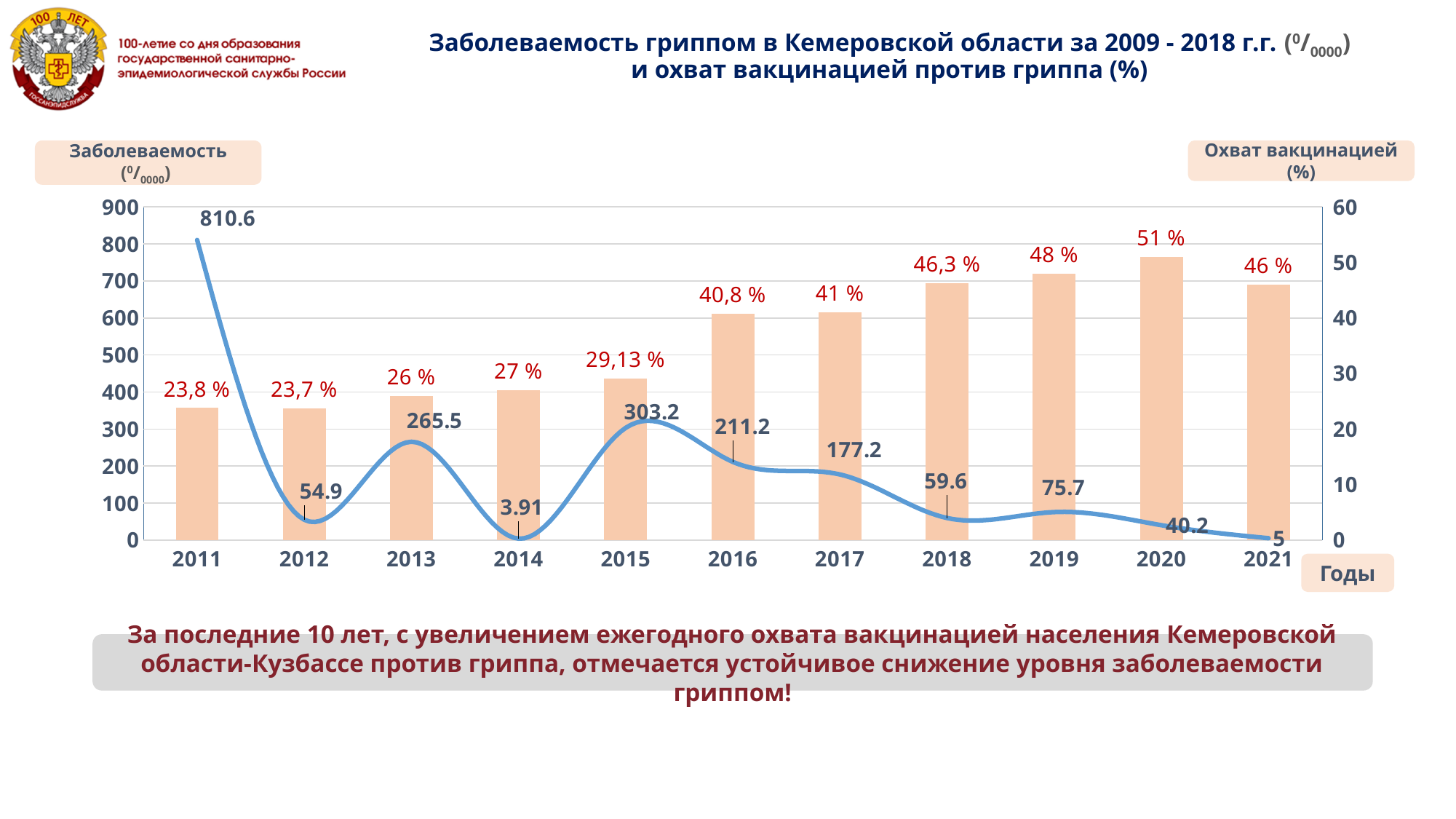
What type of chart is used to show vaccination coverage? Bar chart What was the vaccination coverage against flu in 2020? 51 % What is the difference in vaccination coverage between 2020 and 2021? 5 % In which year was the flu incidence highest? 2011 In which year was the vaccination coverage highest? 2020 What is the overall trend of flu incidence from 2011 to 2021? Falling What was the vaccination coverage in 2015? 29,13 % What was the flu incidence (per 100,000) in Kemerovo region in 2011? 810.6 How many years are shown on the x axis of the chart? 11 What was the flu incidence value in 2014? 3.91 Which year had a higher flu incidence, 2013 or 2015? 2015 In which year was the flu incidence lowest? 2014